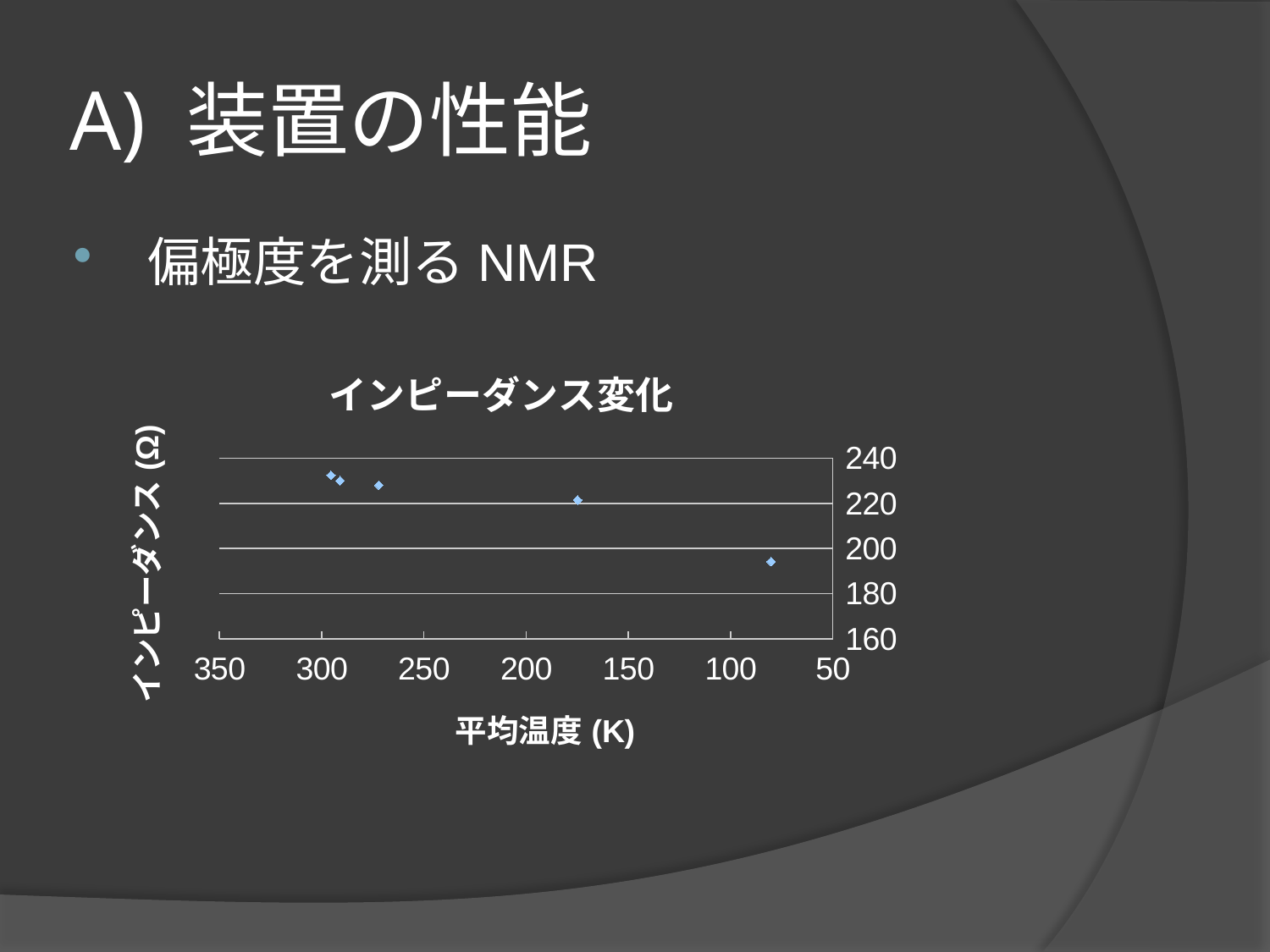
What kind of chart is shown on the slide? scatter chart Is the impedance value for the point near 300 K greater or less than 220? greater Which point has the lowest impedance: the one near 80 K or the one near 300 K? the one near 80 K Is the impedance value for the point near 80 K greater or less than 220? less What is the highest value shown on the y axis of the chart? 240 Is the impedance value for the point near 270 K greater or less than 200? greater Moving from left to right along the x axis, do the impedance values rise or fall? fall How many data points are plotted in the chart? 5 What is the title of the chart? インピーダンス変化 What is the label of the x axis of the chart? 平均温度 (K) Which has the larger impedance: the point near 175 K or the point near 80 K? the point near 175 K